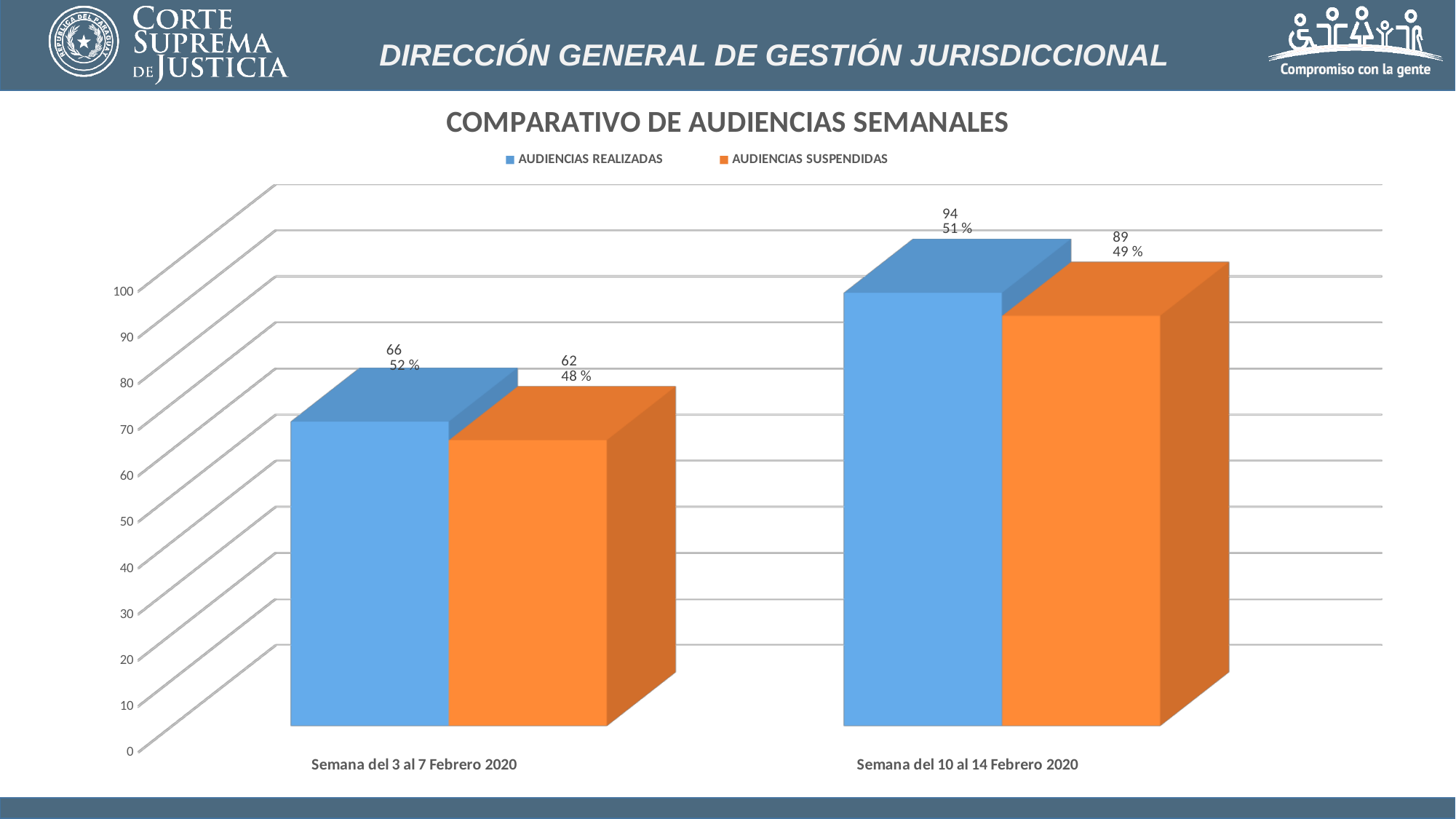
What is the title of the chart? COMPARATIVO DE AUDIENCIAS SEMANALES What is the value of AUDIENCIAS SUSPENDIDAS for Semana del 10 al 14 Febrero 2020? 89 How many weeks (categories) are shown on the x axis? 2 What kind of chart is shown on the slide? Bar chart Which week has the lowest value for AUDIENCIAS SUSPENDIDAS? Semana del 3 al 7 Febrero 2020 What is the value of AUDIENCIAS REALIZADAS for Semana del 3 al 7 Febrero 2020? 66 Which is larger in Semana del 10 al 14 Febrero 2020: AUDIENCIAS REALIZADAS or AUDIENCIAS SUSPENDIDAS? AUDIENCIAS REALIZADAS How many series does the legend list? 2 What percentage is shown for AUDIENCIAS REALIZADAS in Semana del 10 al 14 Febrero 2020? 51 % What percentage is shown for AUDIENCIAS SUSPENDIDAS in Semana del 3 al 7 Febrero 2020? 48 % Which week has the highest value for AUDIENCIAS REALIZADAS? Semana del 10 al 14 Febrero 2020 What is the difference between AUDIENCIAS REALIZADAS in Semana del 10 al 14 Febrero 2020 and Semana del 3 al 7 Febrero 2020? 28